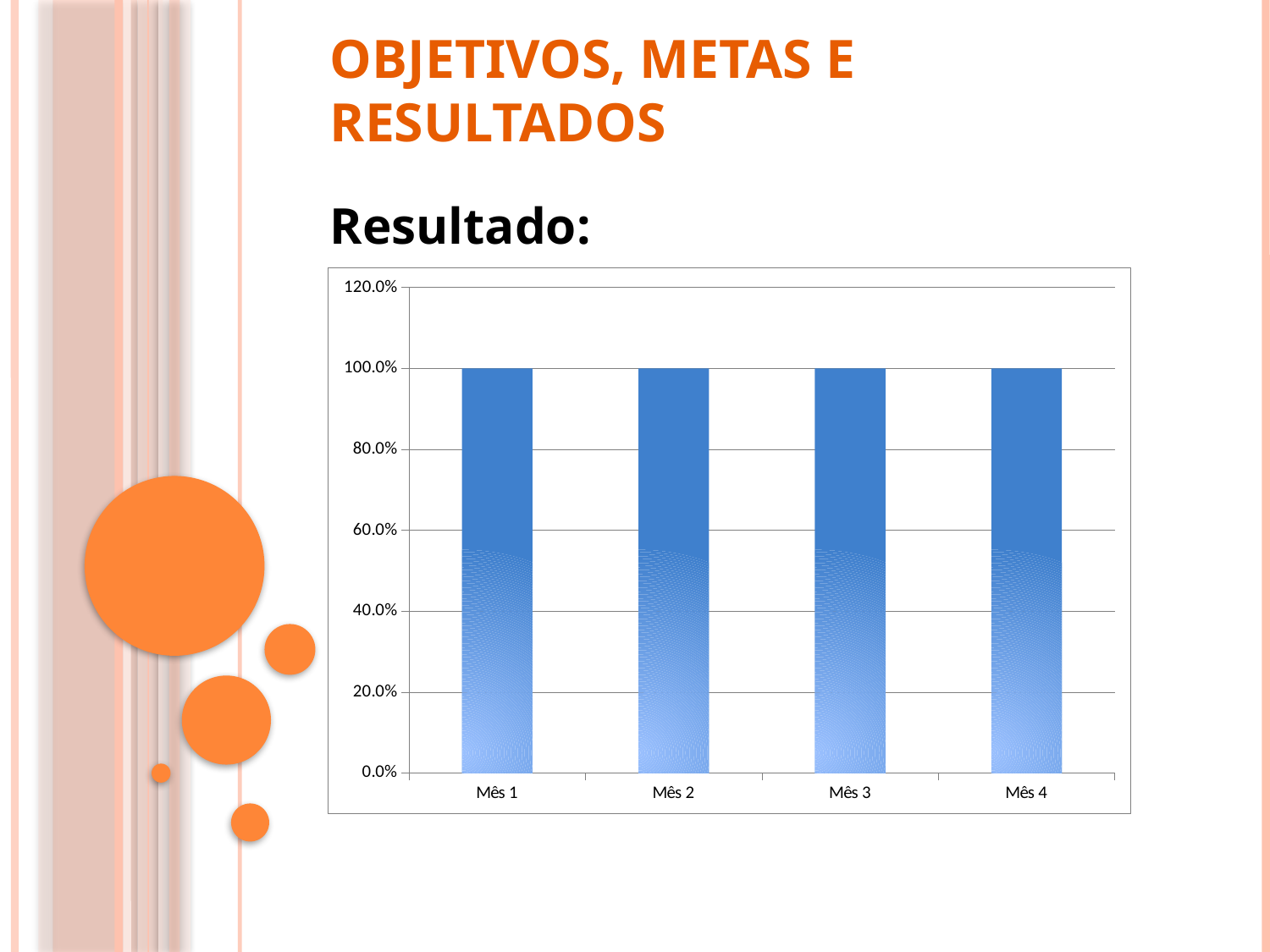
What is the highest value shown on the y axis of the chart? 120.0% Is the value for Mês 2 greater or less than 80.0%? greater What is the value for Mês 4? 100.0% What is the value for Mês 1? 100.0% What type of chart is shown on the slide? bar chart Do the values rise, fall, or stay the same from Mês 1 to Mês 4? stay the same What is the value for Mês 3? 100.0% What is the label of the first category on the x axis? Mês 1 Is the value for Mês 4 greater or less than 120.0%? less How many categories are shown on the x axis of the chart? 4 What is the difference between the values for Mês 1 and Mês 2? 0.0%